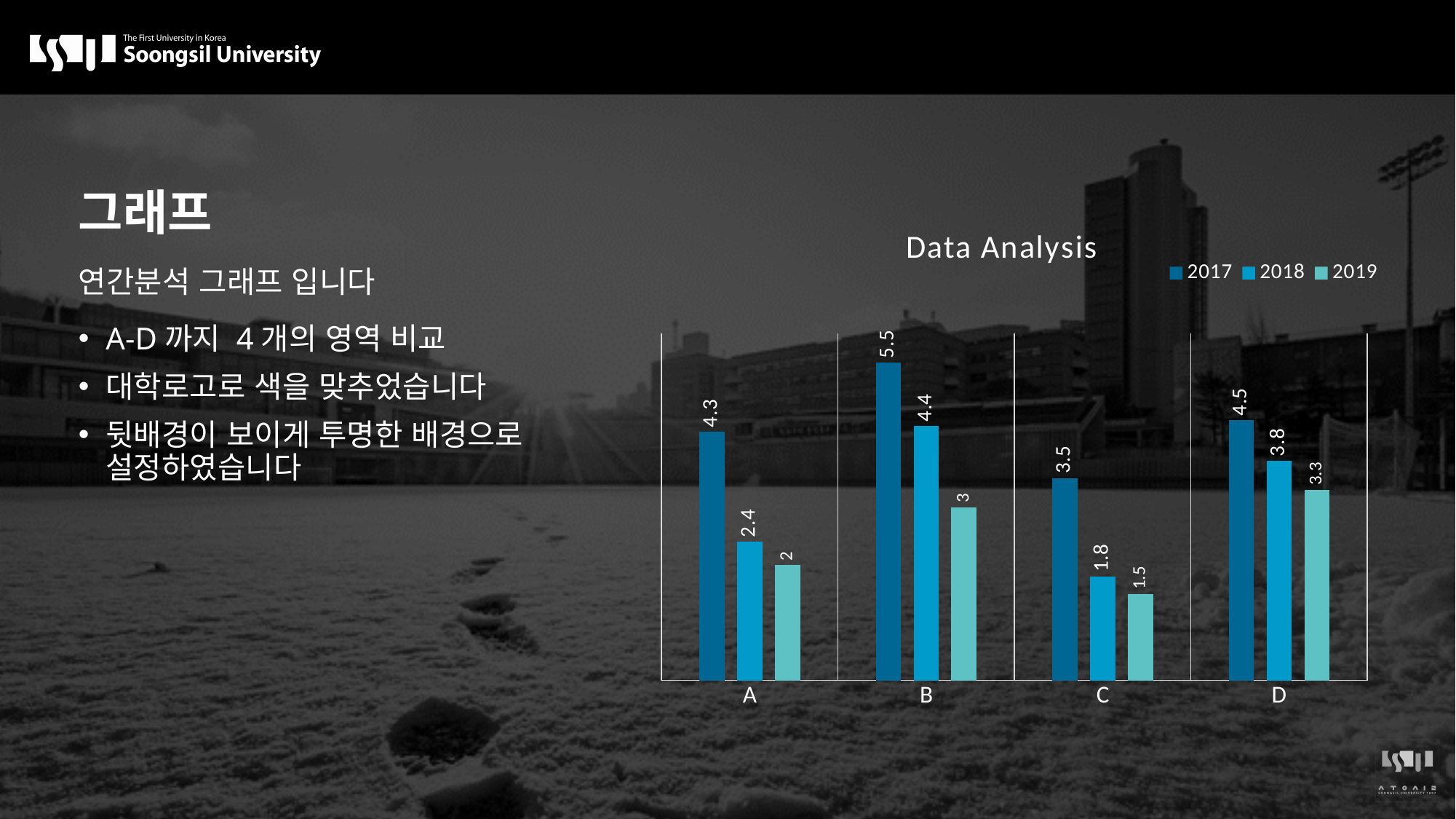
How many series does the legend list? 3 What are the series names listed in the legend? 2017, 2018, 2019 Which is larger: the 2019 value for B or the 2019 value for D? D Which category has the lowest value in the 2019 series? C How many categories are shown on the x axis? 4 What kind of chart is shown on the slide? Bar chart What is the value for category C in the 2019 series? 1.5 What is the value for category D in the 2018 series? 3.8 Which category has the highest value in the 2017 series? B What is the difference between the 2017 and 2018 values for category A? 1.9 What is the title of the chart? Data Analysis What is the value for category B in the 2017 series? 5.5